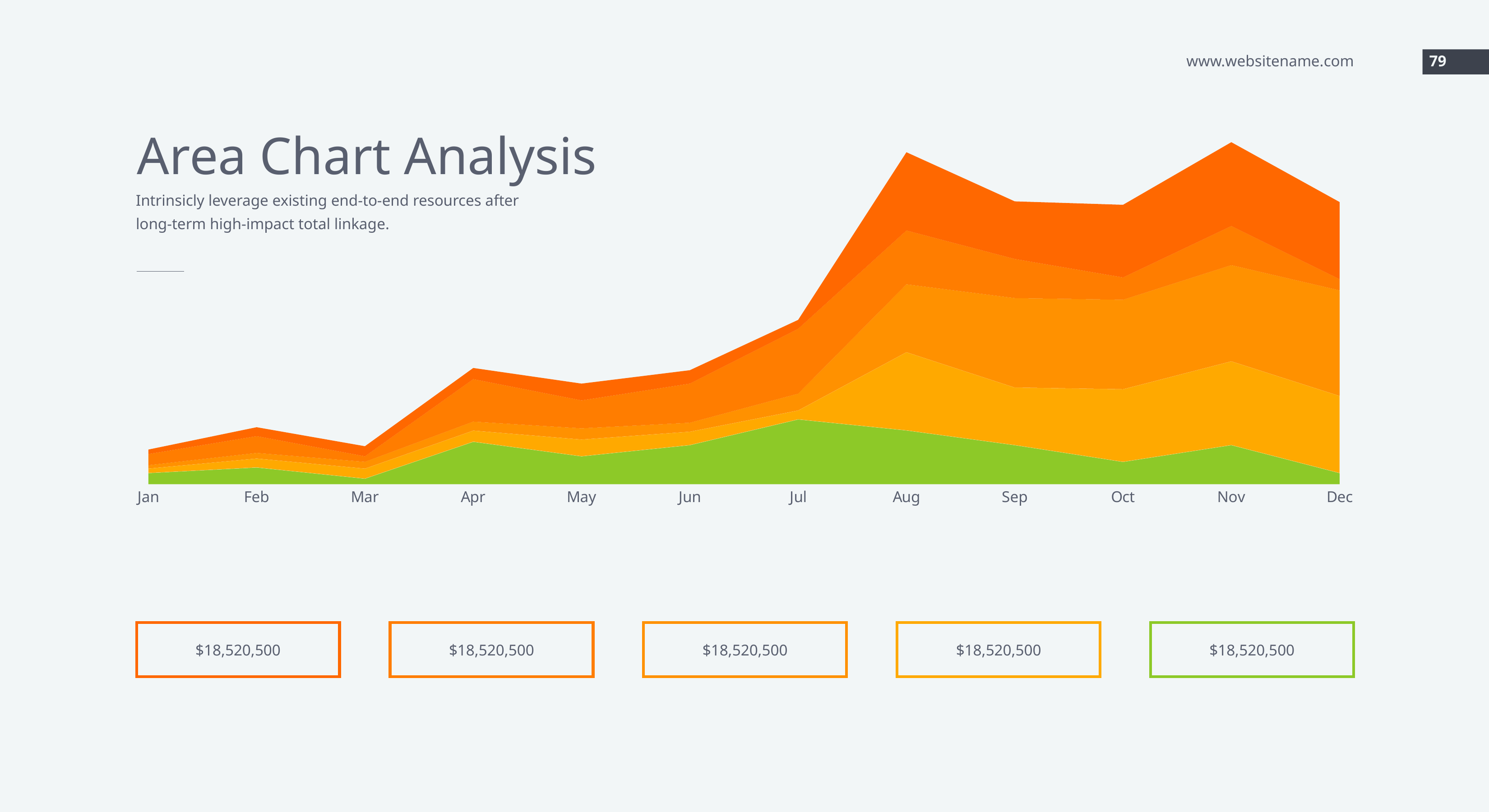
Do the stacked values generally rise or fall from Jan to Dec? rise Is the total stacked value larger in Dec or in Jan? Dec Which month is the first category on the x axis? Jan What is the title of the slide containing the chart? Area Chart Analysis In which month does the total stacked value reach its highest point? Nov Is the green series value larger in Jul or in Oct? Jul In which month does the green (bottom) series reach its highest value? Jul Is the total stacked value larger in Nov or in Mar? Nov What kind of chart is shown on the slide? area chart How many months are shown along the x axis of the chart? 12